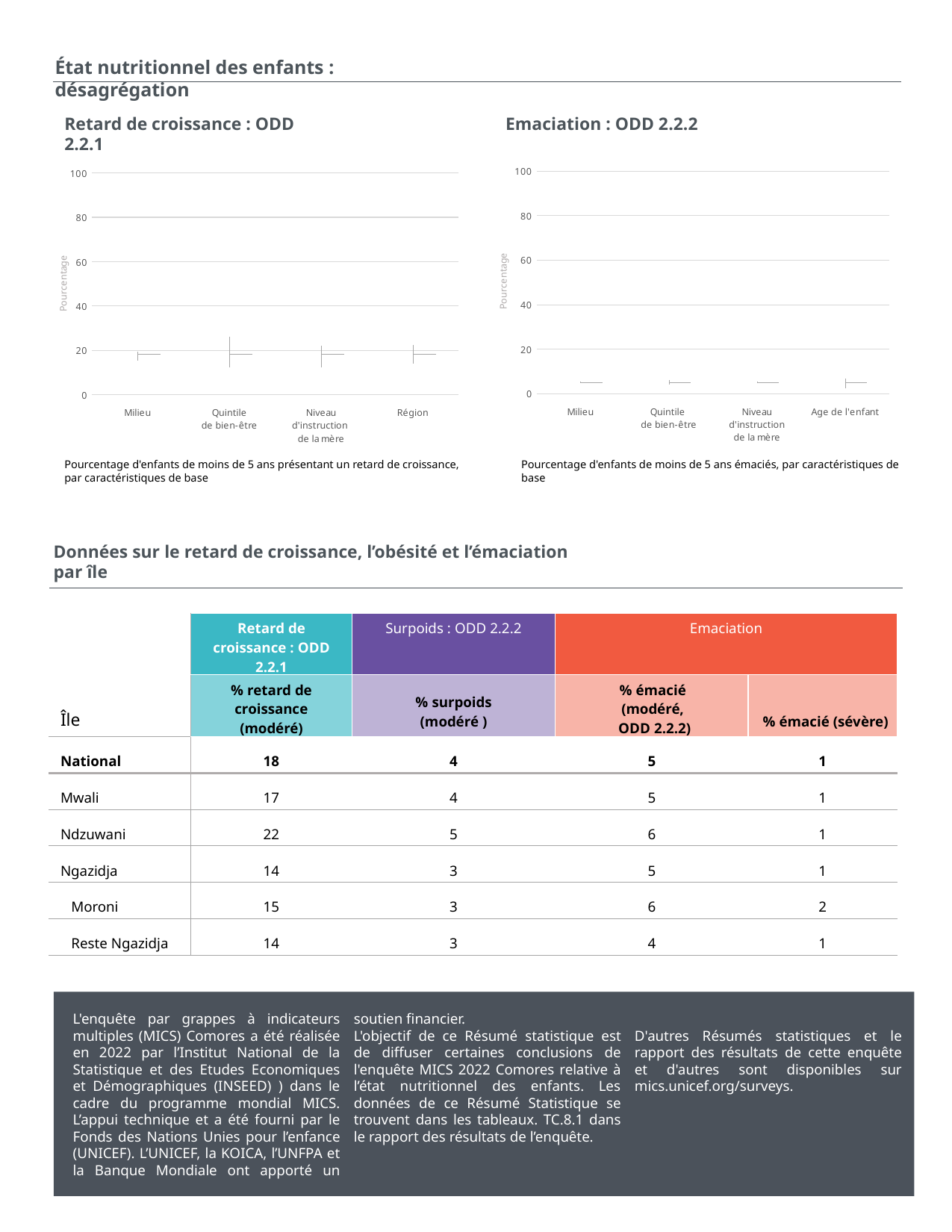
On the 'Retard de croissance : ODD 2.2.1' chart, is the value for Région greater or less than 60? less What is the label of the y axis on the 'Retard de croissance : ODD 2.2.1' chart? Pourcentage On the 'Retard de croissance : ODD 2.2.1' chart, how many categories are shown on the x axis? 4 On the 'Emaciation : ODD 2.2.2' chart, is the value for Milieu greater or less than 20? less On the 'Emaciation : ODD 2.2.2' chart, how many categories are shown on the x axis? 4 What is the highest tick value shown on the y axis of the 'Emaciation : ODD 2.2.2' chart? 100 On the 'Retard de croissance : ODD 2.2.1' chart, is the value for Milieu greater or less than 40? less